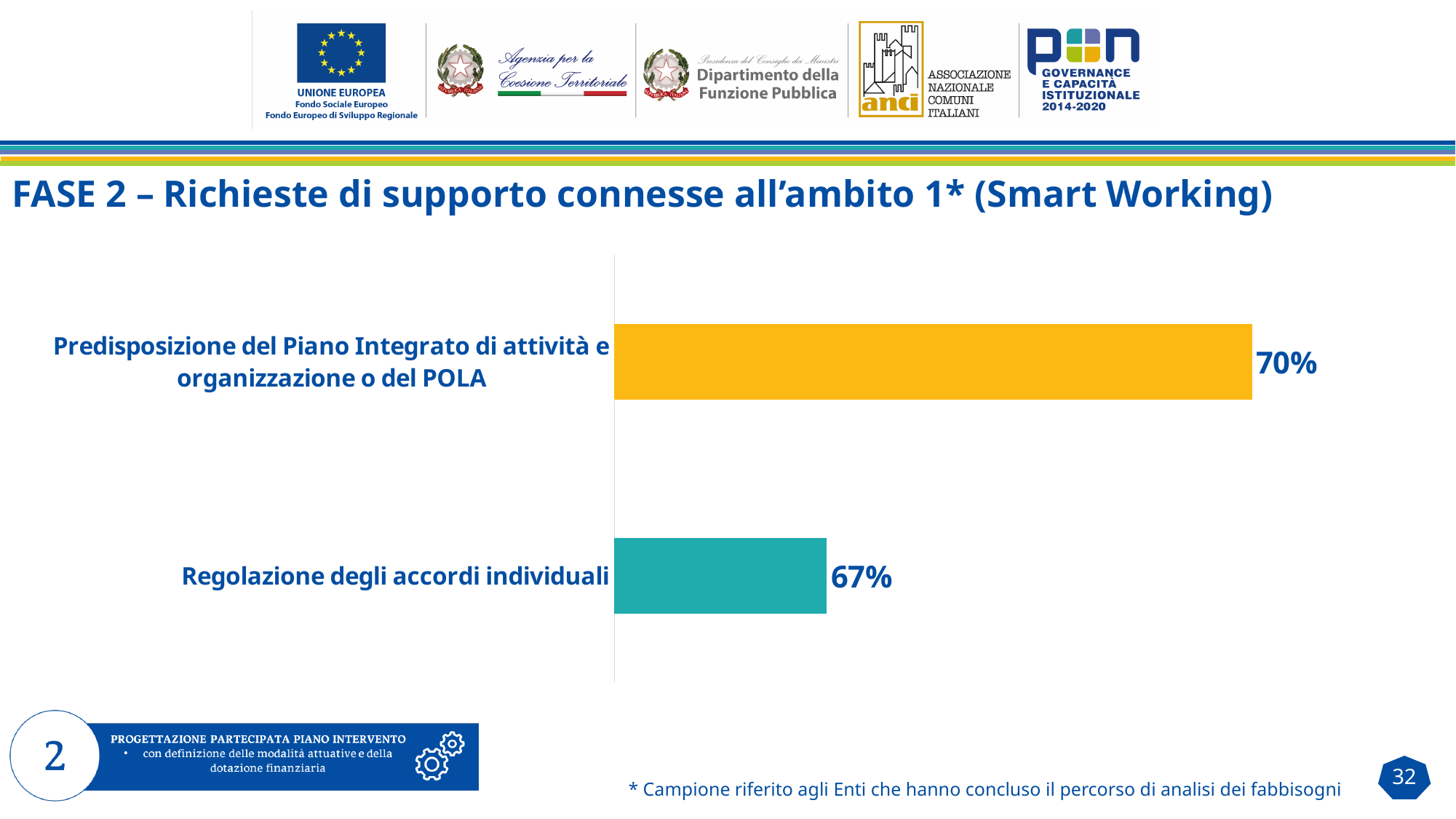
What colour is the bar for 'Regolazione degli accordi individuali'? Teal Which category has the highest value? Predisposizione del Piano Integrato di attività e organizzazione o del POLA Which category has the lowest value? Regolazione degli accordi individuali What is the value for 'Predisposizione del Piano Integrato di attività e organizzazione o del POLA'? 70% Which is larger: the value for 'Predisposizione del Piano Integrato di attività e organizzazione o del POLA' or for 'Regolazione degli accordi individuali'? Predisposizione del Piano Integrato di attività e organizzazione o del POLA What kind of chart is shown on the slide? Bar chart What colour is the bar for 'Predisposizione del Piano Integrato di attività e organizzazione o del POLA'? Yellow What is the value for 'Regolazione degli accordi individuali'? 67% How many categories are shown in the chart? 2 What is the difference between the values for 'Predisposizione del Piano Integrato di attività e organizzazione o del POLA' and 'Regolazione degli accordi individuali'? 3%